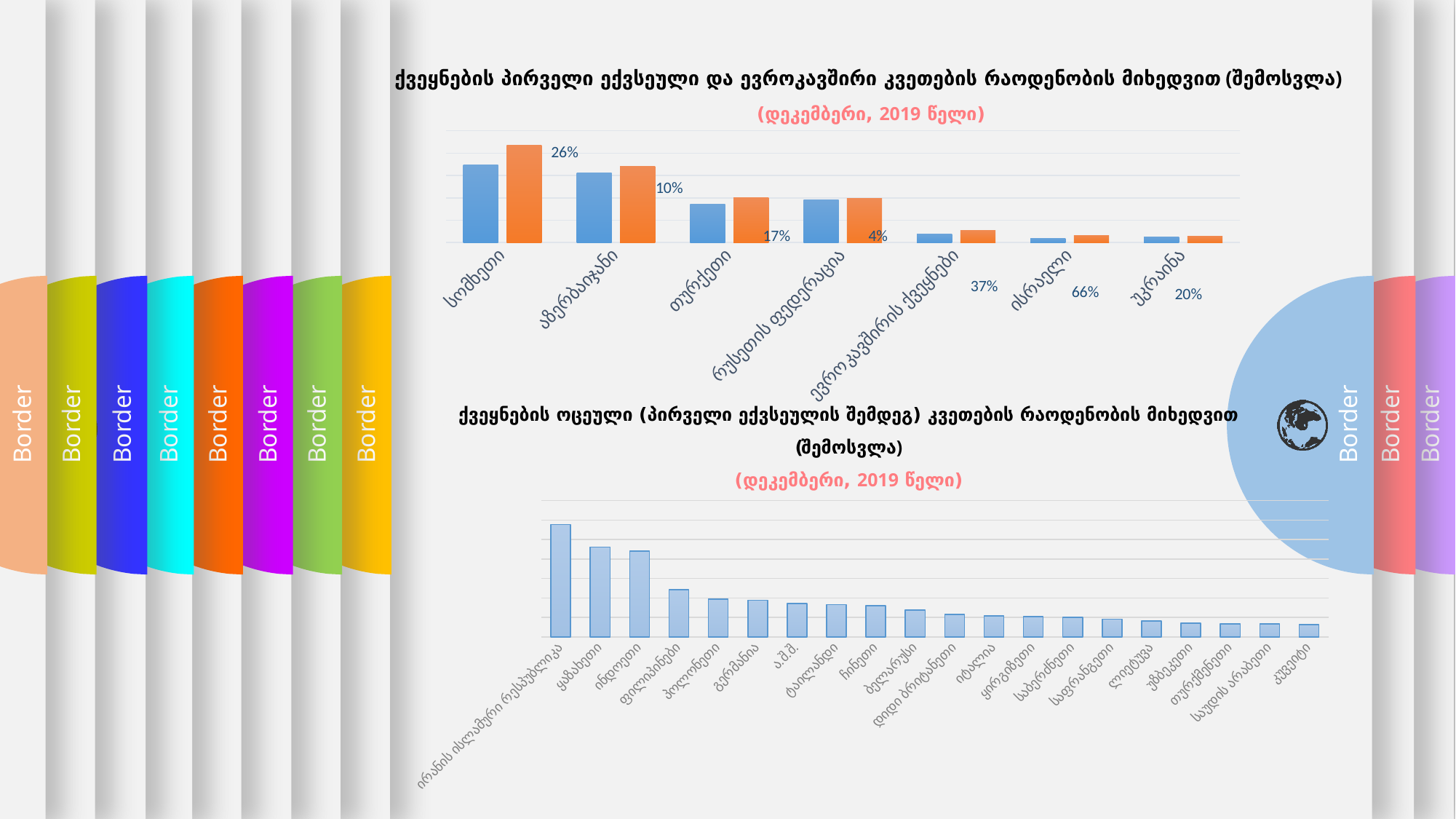
In the top chart, how many categories are shown on the x axis? 7 What kind of chart is the top chart on the slide? bar chart In the top chart, which category has the tallest bars? სომხეთი In the top chart, what percentage label is printed next to რუსეთის ფედერაცია? 4% In the top chart, what percentage label is printed next to ისრაელი? 66% What kind of chart is the bottom chart on the slide? bar chart In the top chart, what percentage label is printed next to სომხეთი? 26% In the bottom chart, which country has the shortest bar? კუვეიტი In the bottom chart, do the bar heights rise or fall from left to right? fall In the bottom chart, how many countries are shown on the x axis? 20 In the bottom chart, which country has the tallest bar? ირანის ისლამური რესპუბლიკა In the top chart, how many bars are plotted for each category? 2